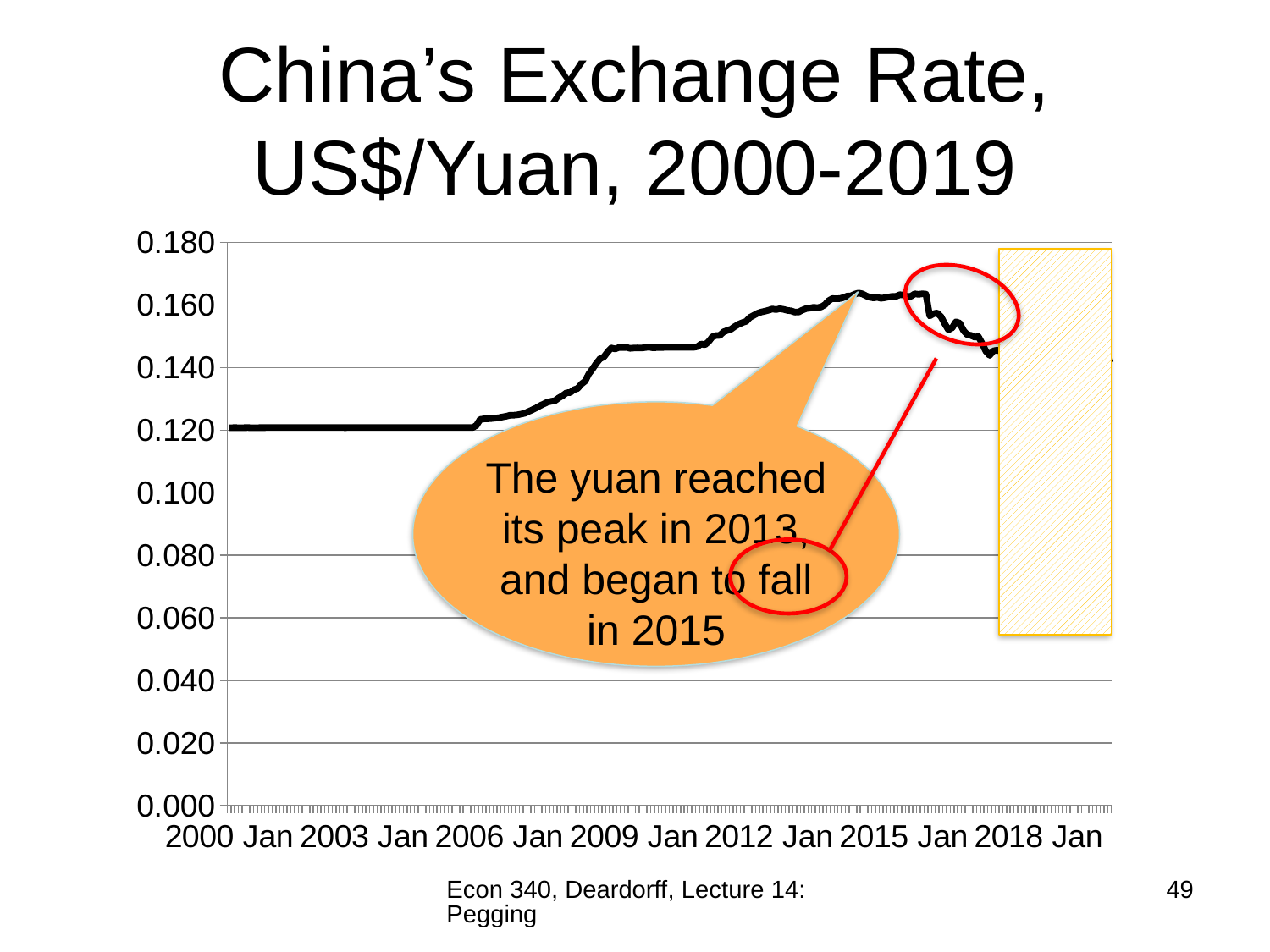
Does the exchange rate rise or fall between 2015 Jan and 2018 Jan? fall Is the exchange rate in 2000 Jan greater or less than 0.140? less Is the exchange rate in 2012 Jan greater or less than 0.140? greater What is the highest value shown on the y axis? 0.180 Which is larger, the exchange rate in 2009 Jan or in 2003 Jan? 2009 Jan Is the exchange rate in 2009 Jan greater or less than 0.120? greater What is the title of the chart? China's Exchange Rate, US$/Yuan, 2000-2019 What kind of chart is shown on the slide? line chart Which is larger, the exchange rate in 2003 Jan or in 2012 Jan? 2012 Jan Does the exchange rate rise or fall between 2006 Jan and 2012 Jan? rise